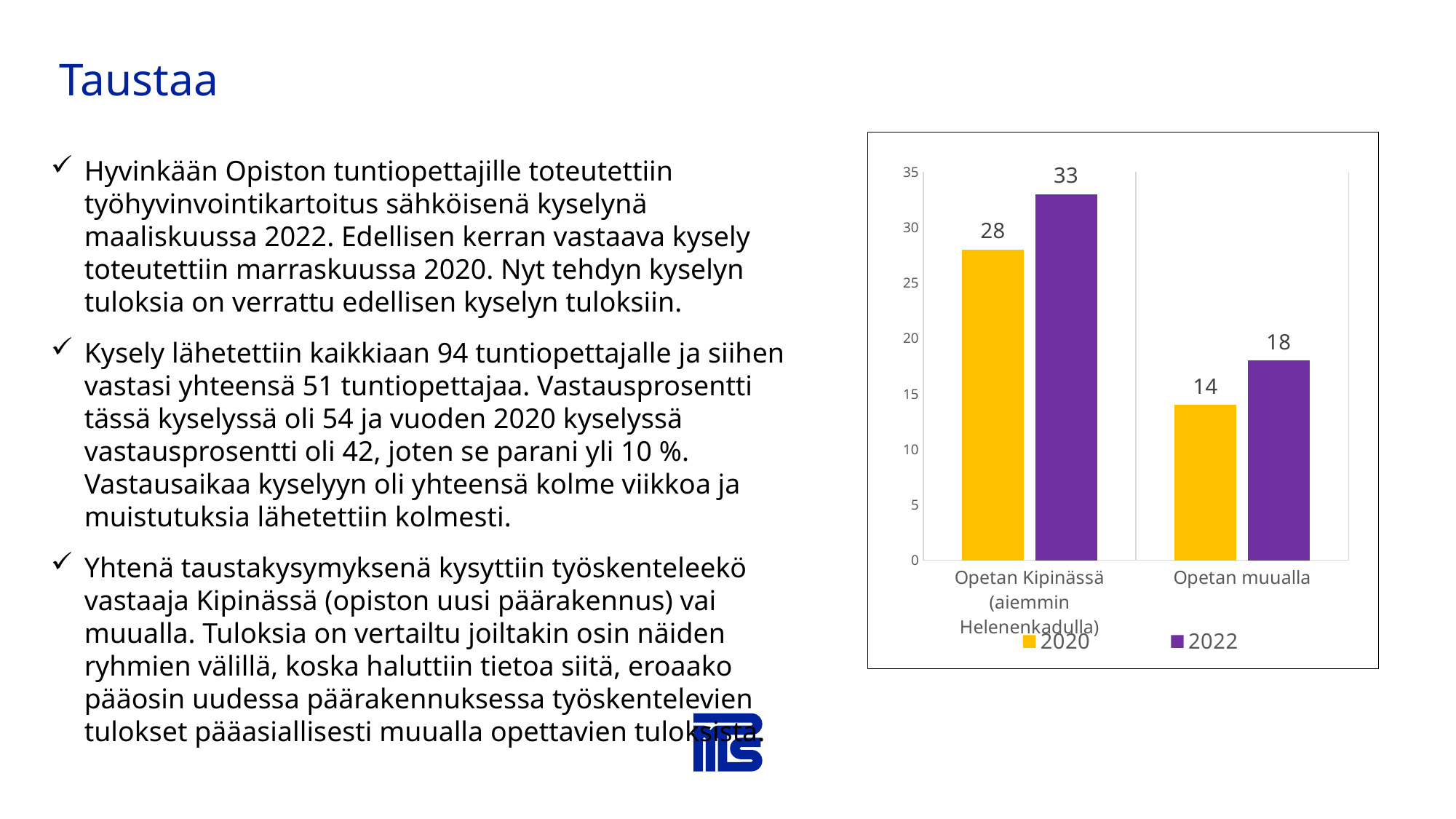
What is the 2022 value for "Opetan muualla"? 18 What is the 2020 value for "Opetan Kipinässä (aiemmin Helenenkadulla)"? 28 What is the difference between the 2022 and 2020 values for "Opetan muualla"? 4 Which bar in the chart has the highest value? 2022, Opetan Kipinässä (aiemmin Helenenkadulla) How many categories are shown on the x axis of the chart? 2 What is the 2020 value for "Opetan muualla"? 14 What kind of chart is shown on the slide? Bar chart Which bar in the chart has the lowest value? 2020, Opetan muualla What is the difference between the 2022 and 2020 values for "Opetan Kipinässä (aiemmin Helenenkadulla)"? 5 How many series does the chart legend list? 2 Which is larger: the 2020 value for "Opetan Kipinässä" or the 2022 value for "Opetan muualla"? 2020 value for Opetan Kipinässä What is the 2022 value for "Opetan Kipinässä (aiemmin Helenenkadulla)"? 33